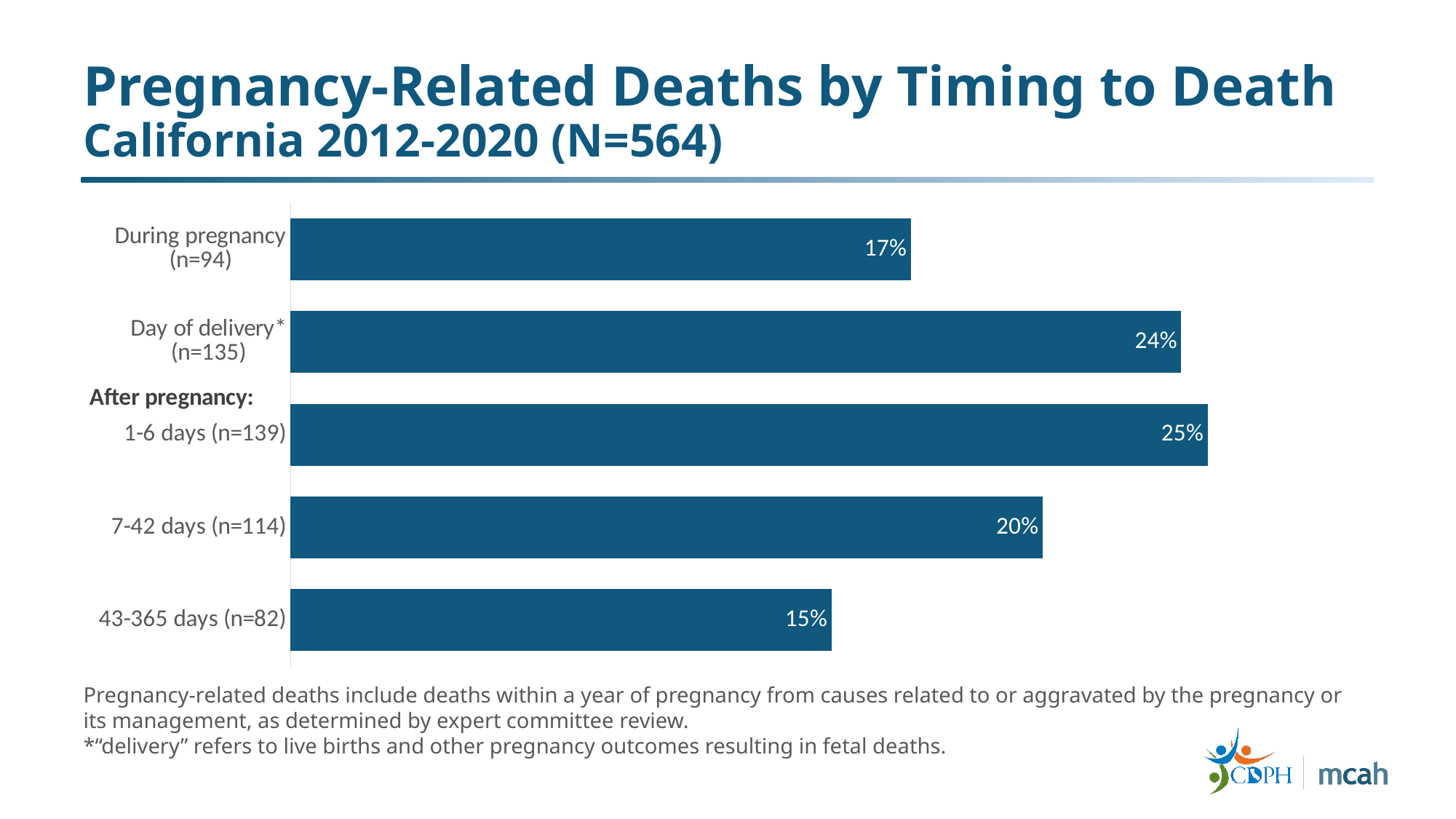
Which is larger: the percentage of deaths 7-42 days after pregnancy or the percentage during pregnancy? 7-42 days after pregnancy What is the difference in percentage points between deaths 1-6 days after pregnancy and deaths 43-365 days after pregnancy? 10 Which timing category has the highest percentage of pregnancy-related deaths? 1-6 days (n=139) What is the difference in percentage points between deaths on the day of delivery and deaths during pregnancy? 7 How many timing categories are shown in the chart? 5 What percentage of pregnancy-related deaths occurred 7-42 days after pregnancy? 20% Which timing category has the lowest percentage of pregnancy-related deaths? 43-365 days (n=82) What type of chart is shown on the slide? Bar chart What percentage of pregnancy-related deaths occurred 43-365 days after pregnancy? 15% How many deaths (n) are in the 'Day of delivery' category? 135 What percentage of pregnancy-related deaths occurred during pregnancy? 17% What percentage of pregnancy-related deaths occurred on the day of delivery? 24%